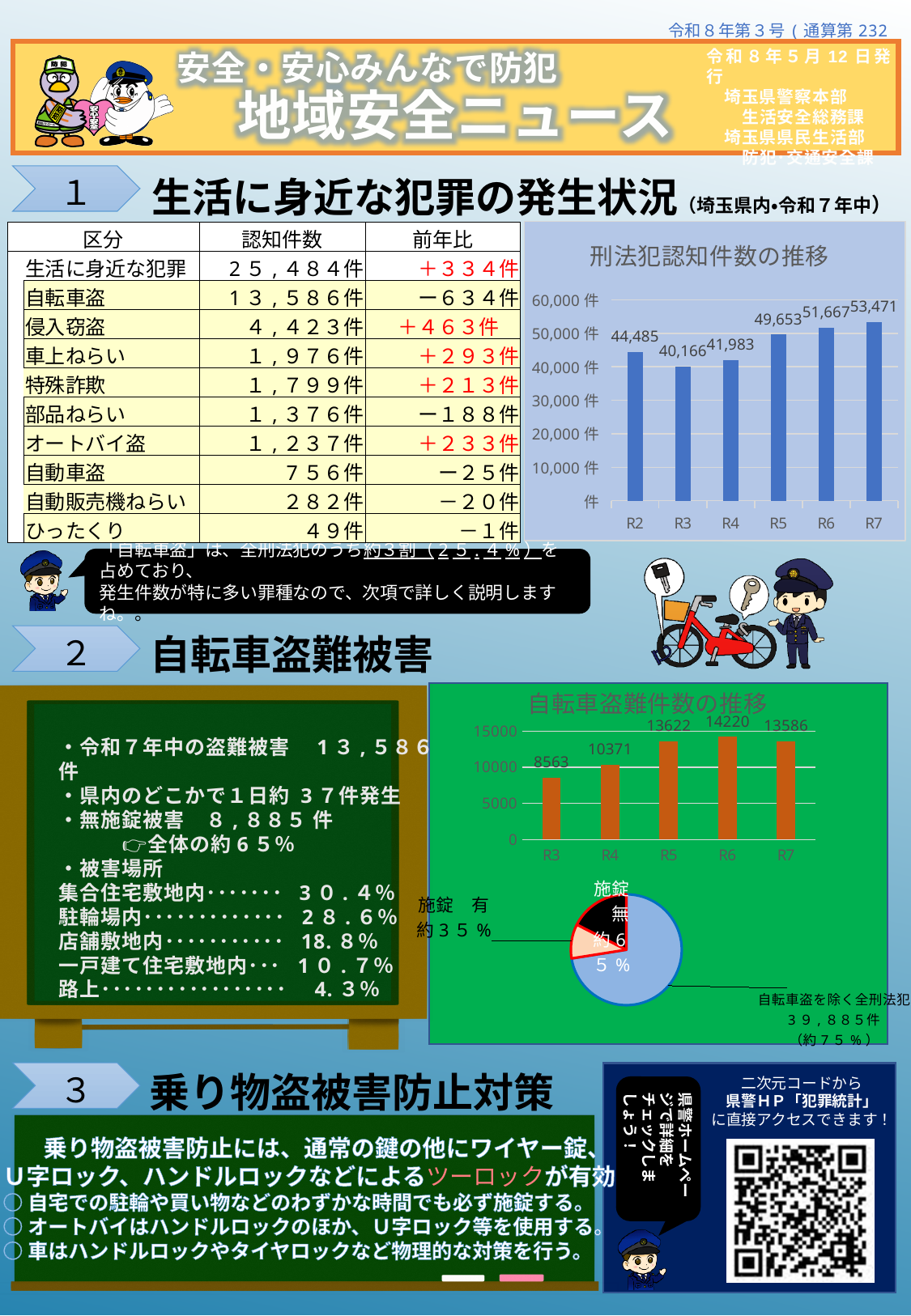
「刑法犯認知件数の推移」のグラフで、最も値が低い年度はどれですか？ R3 「刑法犯認知件数の推移」のグラフで、R7の値はいくつですか？ 53,471 「刑法犯認知件数の推移」のグラフで、R3の値はいくつですか？ 40,166 「刑法犯認知件数の推移」のグラフで、R7とR6の差はいくつですか？ 1,804 「自転車盗難件数の推移」のグラフで、R3からR6にかけて値は増加していますか、減少していますか？ 増加 「自転車盗難件数の推移」のグラフで、R6の値はいくつですか？ 14220 「刑法犯認知件数の推移」のグラフは、どの種類のグラフですか？ 棒グラフ 「自転車盗難件数の推移」のグラフで、R4とR3の差はいくつですか？ 1808 「自転車盗難件数の推移」のグラフで、最も値が高い年度はどれですか？ R6 「刑法犯認知件数の推移」のグラフで、最も値が高い年度はどれですか？ R7 「刑法犯認知件数の推移」のグラフには、いくつの年度が表示されていますか？ 6 「自転車盗難件数の推移」のグラフで、R3とR4ではどちらの値が大きいですか？ R4